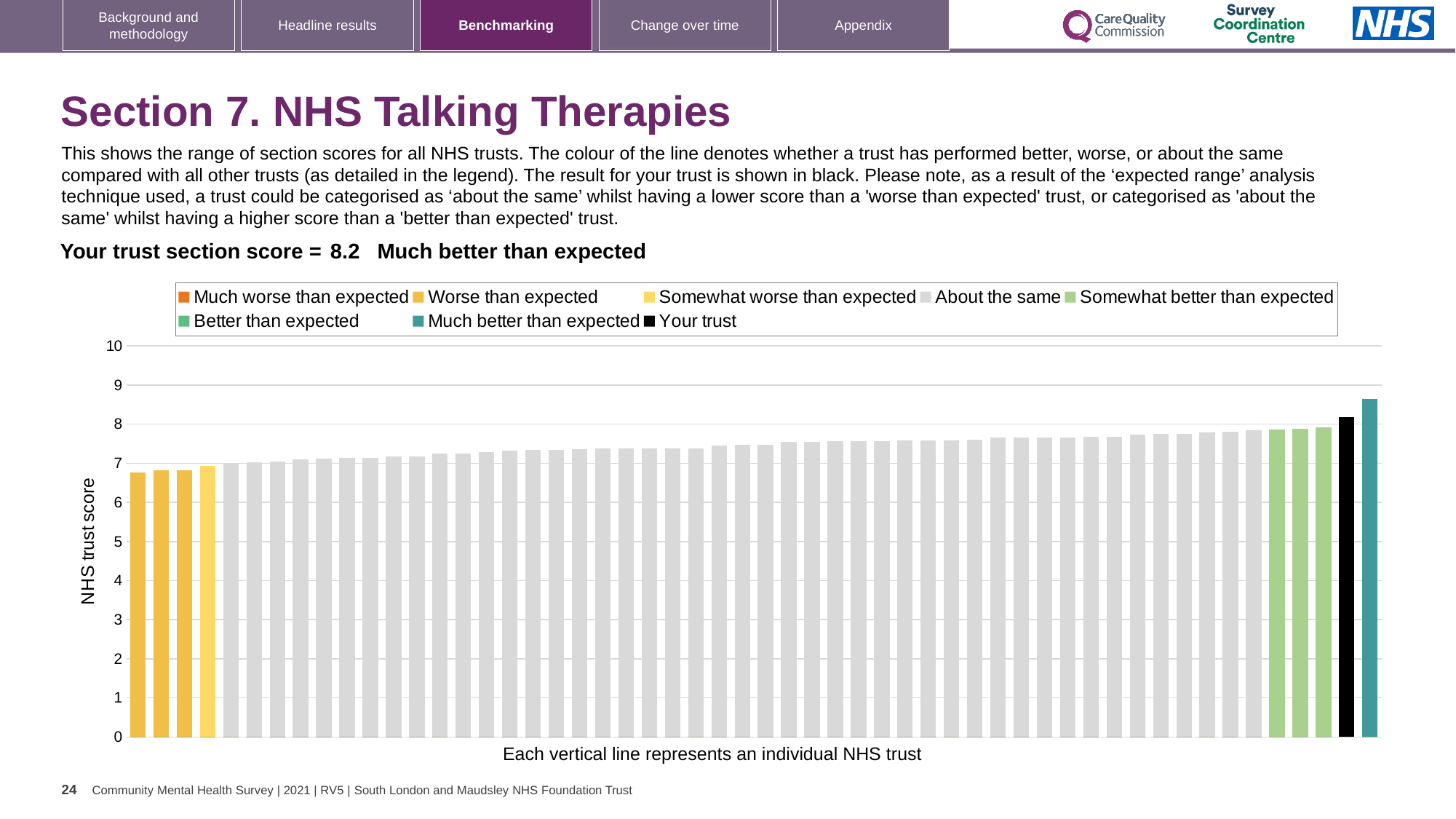
Is the value of the tallest bar in the chart greater or less than 9? less Is the value of the lowest bar in the chart greater or less than 7? less Do the bar values rise or fall from left to right along the x axis? Rise What kind of chart is shown on the slide? Bar chart Is the value for your trust (black bar) greater or less than 8? greater How many entries does the chart legend list? 8 What is the section score for your trust shown on the slide? 8.2 What colour is the bar representing your trust? Black Which is larger: the value for your trust (black bar) or the value of the teal 'Much better than expected' bar? The teal 'Much better than expected' bar What is the label on the y axis of the chart? NHS trust score Which legend category does the tallest bar in the chart belong to? Much better than expected How many bars are coloured as 'Much better than expected' (teal)? 1